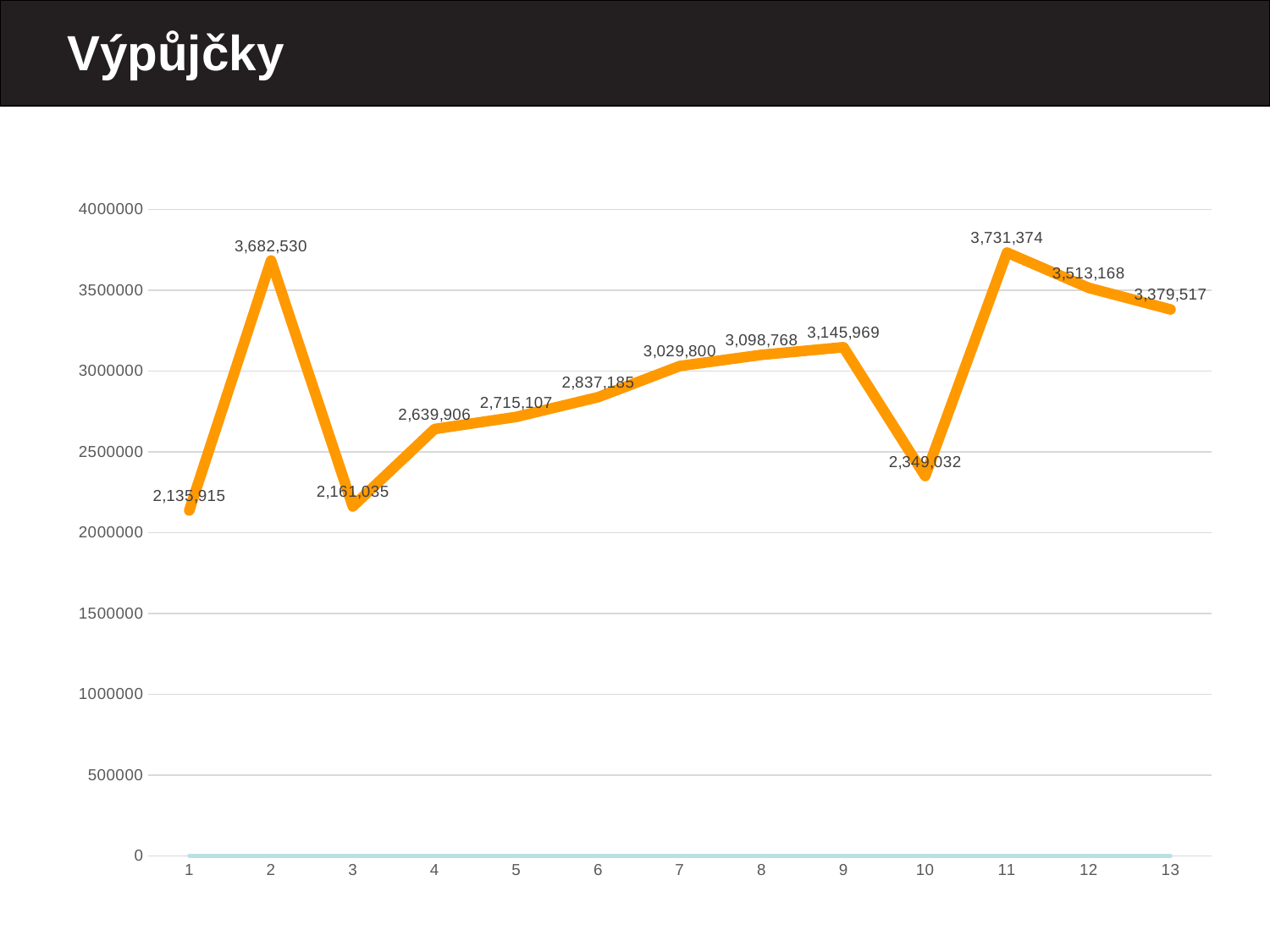
Which point on the x axis has the lowest value? 1 What is the value at point 2? 3,682,530 Which is larger, the value at point 4 or the value at point 7? point 7 Which point on the x axis has the highest value? 11 Do the values rise or fall from point 4 to point 9? rise What type of chart is shown on the slide? line chart Is the value at point 3 greater or less than 2500000? less What is the difference between the values at point 9 and point 10? 796,937 What is the value at point 10? 2,349,032 What is the difference between the values at point 11 and point 2? 48,844 What is the value at point 13? 3,379,517 How many points are plotted on the x axis? 13